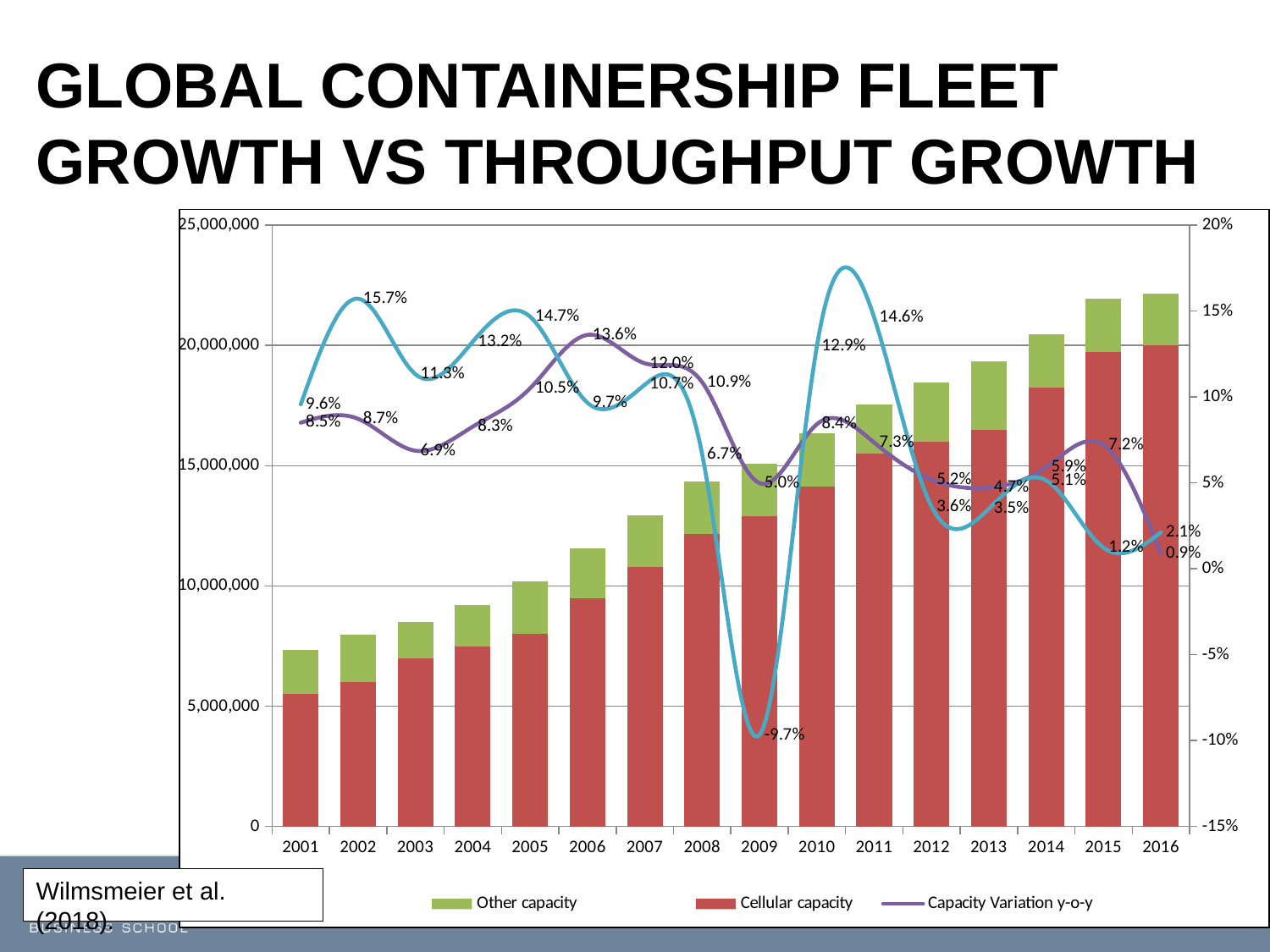
Is the total height of the stacked bar for 2001 greater or less than 10,000,000? less Which year has the larger Capacity Variation y-o-y value, 2002 or 2003? 2002 In which year is the Capacity Variation y-o-y line at its highest labelled value? 2006 What is the difference between the Capacity Variation y-o-y values for 2006 and 2016? 12.7 percentage points How many years are shown on the x axis? 16 Do the stacked capacity bars generally rise or fall from 2001 to 2016? rise What value is labelled on the blue line for 2009? -9.7% What is the Capacity Variation y-o-y value for 2006? 13.6% In which year is the Capacity Variation y-o-y line at its lowest labelled value? 2016 Is the total height of the stacked bar for 2016 greater or less than 20,000,000? greater What kind of chart is shown on the slide? A combination stacked bar and line chart What is the Capacity Variation y-o-y value for 2016? 0.9%